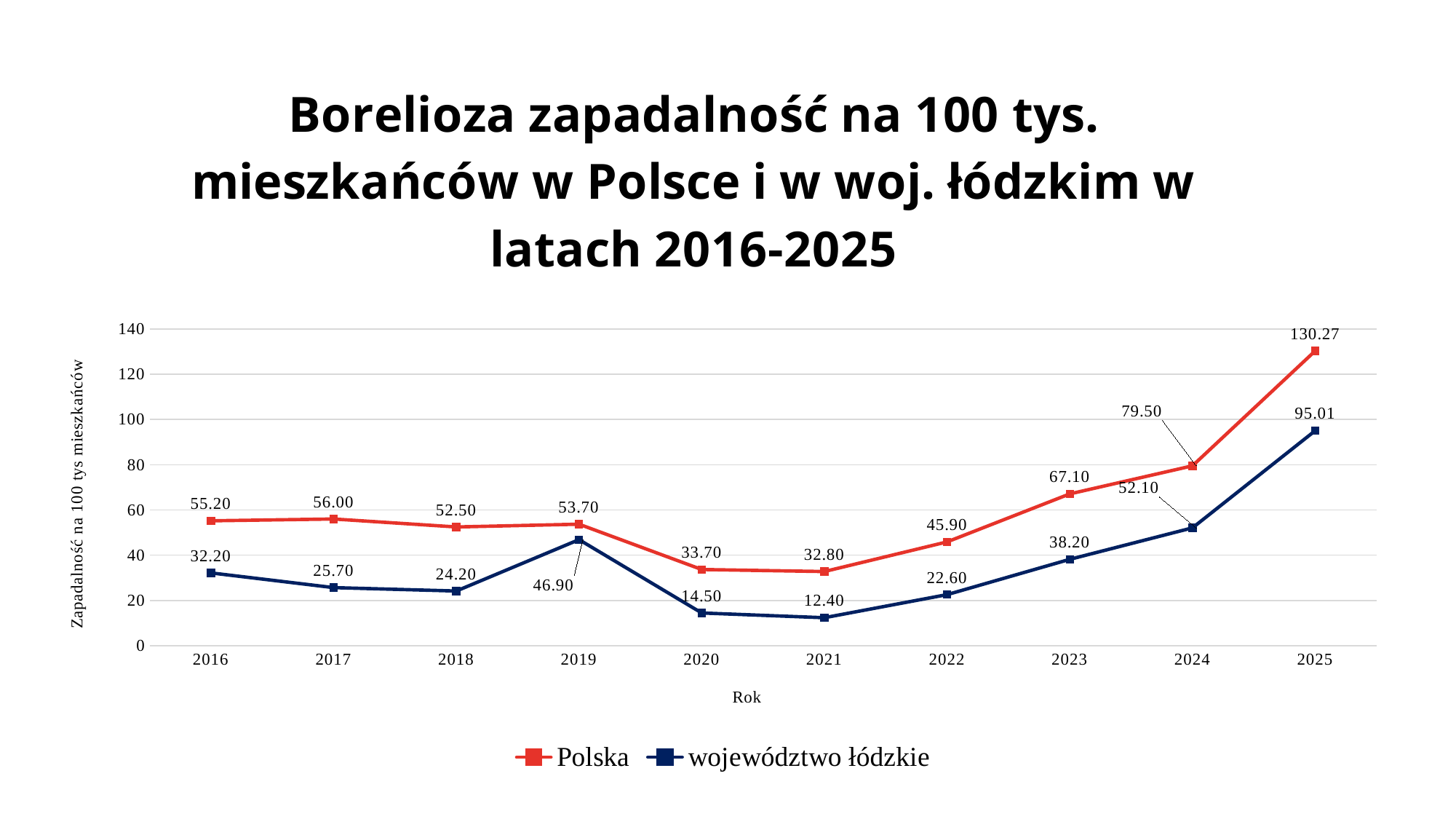
Is the value for Polska in 2023 greater or less than 60? greater How many series does the legend list? 2 What is the value for województwo łódzkie in 2019? 46.90 In which year is the value for Polska lowest? 2021 What kind of chart is shown? line chart How many years are shown on the x axis? 10 What is the value for województwo łódzkie in 2021? 12.40 What is the value for Polska in 2025? 130.27 In which year is the value for województwo łódzkie highest? 2025 Which is larger in 2020: the value for Polska or for województwo łódzkie? Polska What is the difference between the Polska and województwo łódzkie values in 2024? 27.40 Do the values for Polska rise or fall from 2021 to 2025? rise